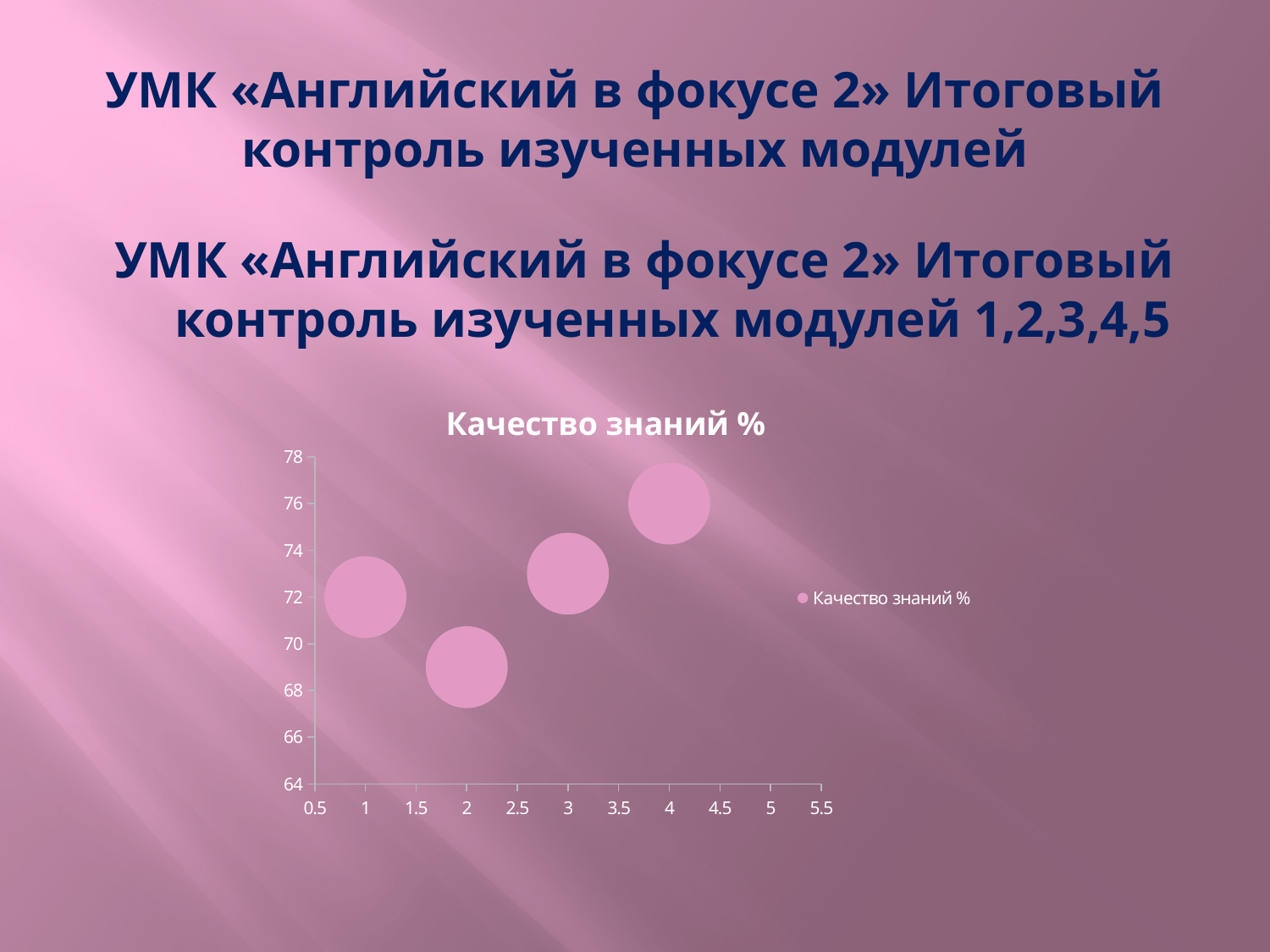
Is the value of the bubble at x = 1 greater or less than 70? greater At which x-axis position is the bubble with the highest value? 4 At which x-axis position is the bubble with the lowest value? 2 Is the value of the bubble at x = 4 greater or less than 74? greater Which bubble has the larger value, the one at x = 4 or the one at x = 2? x = 4 How many series does the legend list? 1 What is the title of the chart? Качество знаний % Is the value of the bubble at x = 3 greater or less than 72? greater What is the name of the series shown in the legend? Качество знаний % How many bubbles are plotted on the chart? 4 What kind of chart is shown on the slide? bubble chart